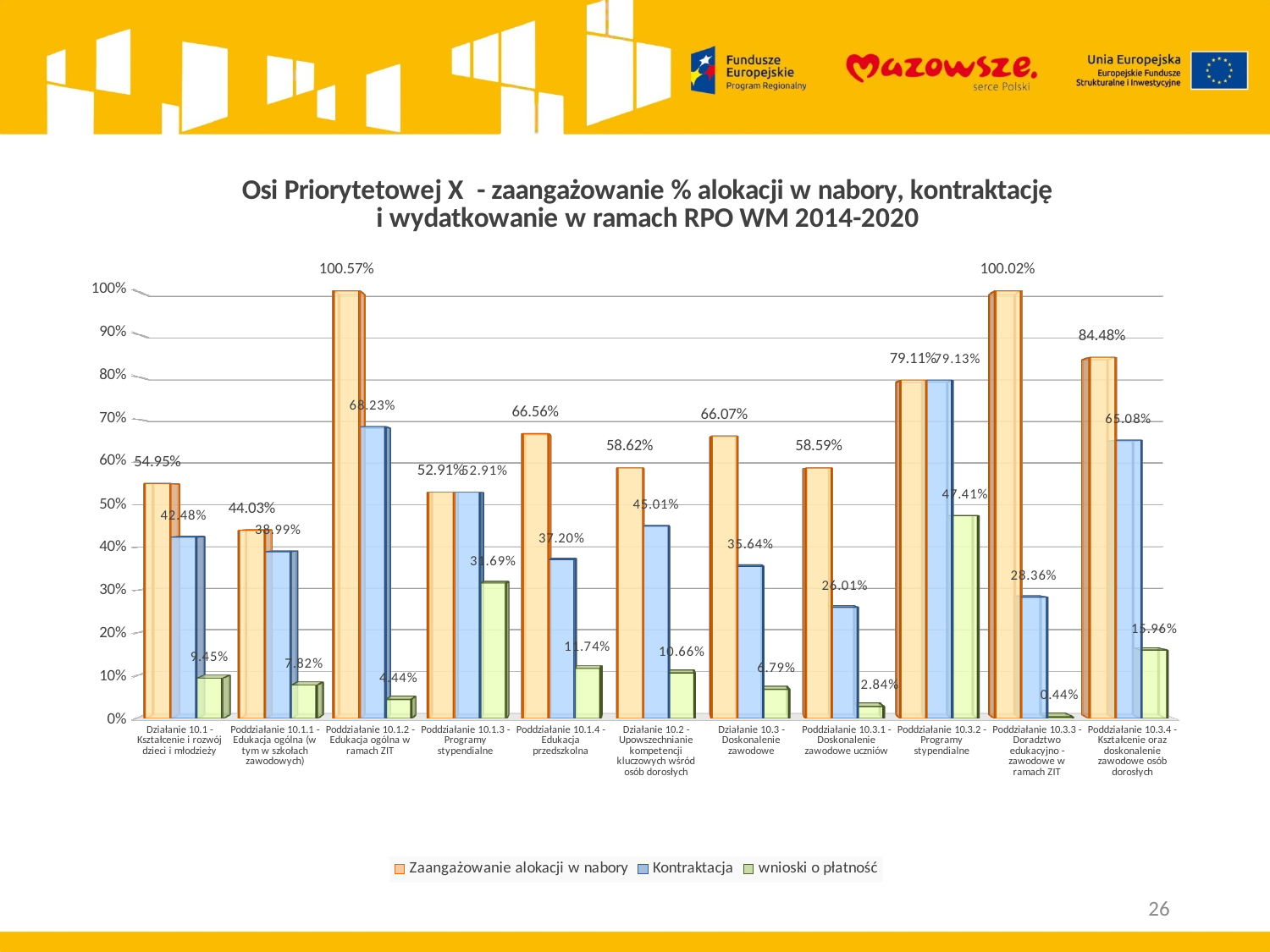
Which is larger: Kontraktacja for Działanie 10.2 - Upowszechnianie kompetencji kluczowych wśród osób dorosłych or Kontraktacja for Działanie 10.3 - Doskonalenie zawodowe? Działanie 10.2 - Upowszechnianie kompetencji kluczowych wśród osób dorosłych Which category has the highest value for Zaangażowanie alokacji w nabory? Poddziałanie 10.1.2 - Edukacja ogólna w ramach ZIT What is the value of Zaangażowanie alokacji w nabory for Poddziałanie 10.1.2 - Edukacja ogólna w ramach ZIT? 100.57% Which category has the lowest value for wnioski o płatność? Poddziałanie 10.3.3 - Doradztwo edukacyjno-zawodowe w ramach ZIT Which category has the highest value for Kontraktacja? Poddziałanie 10.3.2 - Programy stypendialne What is the difference between Zaangażowanie alokacji w nabory and Kontraktacja for Poddziałanie 10.1.2 - Edukacja ogólna w ramach ZIT? 32.34 percentage points What is the value of wnioski o płatność for Poddziałanie 10.3.2 - Programy stypendialne? 47.41% What type of chart is shown on the slide? Bar chart What is the value of Kontraktacja for Poddziałanie 10.3.4 - Kształcenie oraz doskonalenie zawodowe osób dorosłych? 65.08% How many series does the legend list? 3 How many categories (działania/poddziałania) are shown on the x axis? 11 Which series is shown in green in the legend? wnioski o płatność